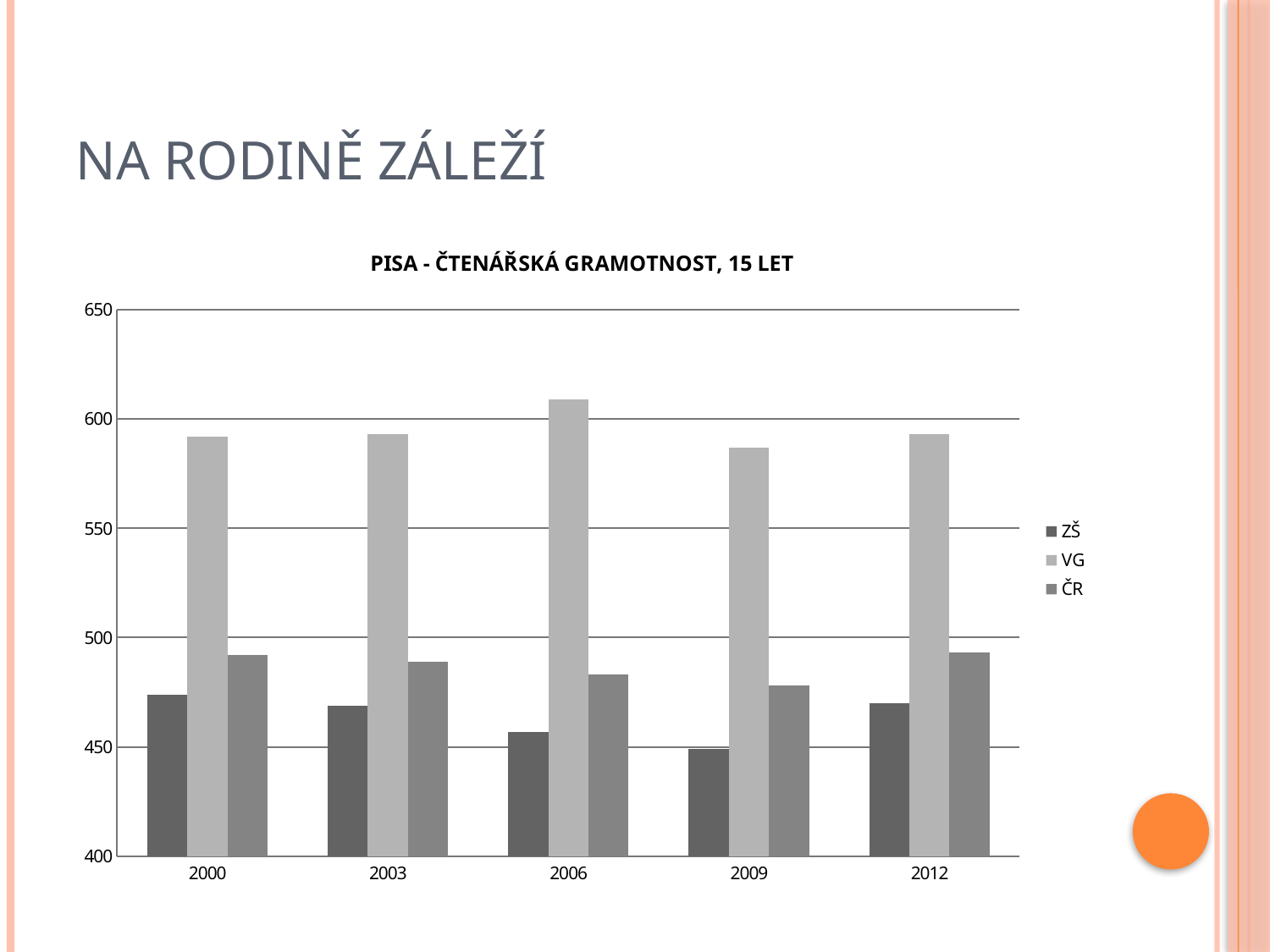
Is the VG value for 2009 greater or less than 600? less How many series does the legend list? 3 What kind of chart is shown on the slide? bar chart In which year is the VG value highest? 2006 Which is larger in 2012, the VG value or the ZŠ value? VG In which year is the ZŠ value lowest? 2009 How many years are shown on the x axis? 5 Is the VG value for 2006 greater or less than 600? greater Which series are listed in the legend? ZŠ, VG, ČR Is the ČR value for 2000 greater or less than 500? less Do the ZŠ values rise or fall from 2000 to 2009? fall What is the title of the chart? PISA - ČTENÁŘSKÁ GRAMOTNOST, 15 LET